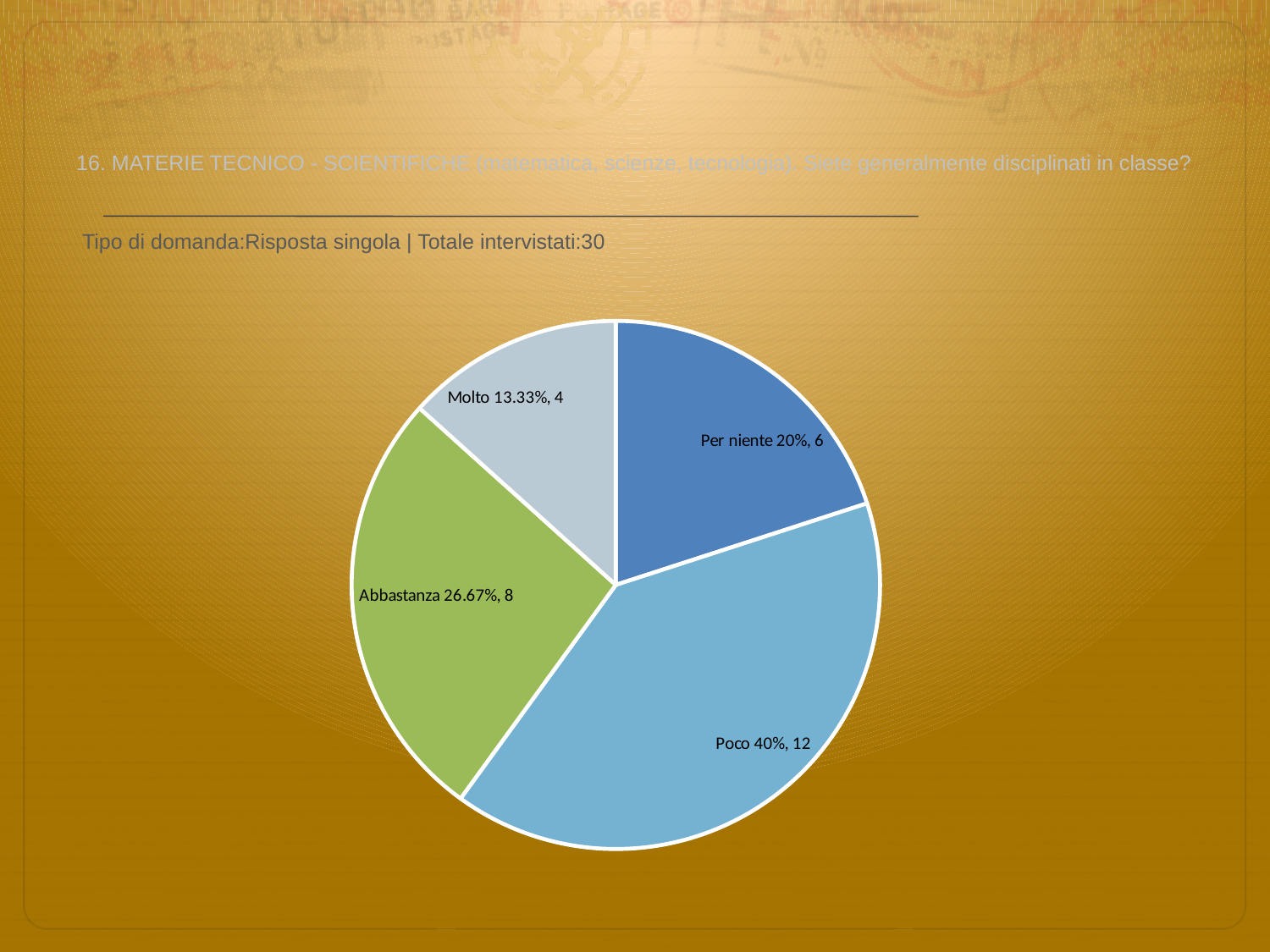
Which category has the smallest slice of the pie? Molto What percentage share does the "Poco" slice have? 40% What kind of chart is shown on the slide? pie chart Which has more respondents, "Abbastanza" or "Molto"? Abbastanza What is the difference in respondent count between "Poco" and "Per niente"? 6 What colour is the "Abbastanza" slice? green Which category has the largest slice of the pie? Poco How many respondents answered "Per niente"? 6 How many slices does the pie chart have? 4 What is the total number of respondents across all slices? 30 What percentage share does the "Molto" slice have? 13.33% How many respondents answered "Abbastanza"? 8